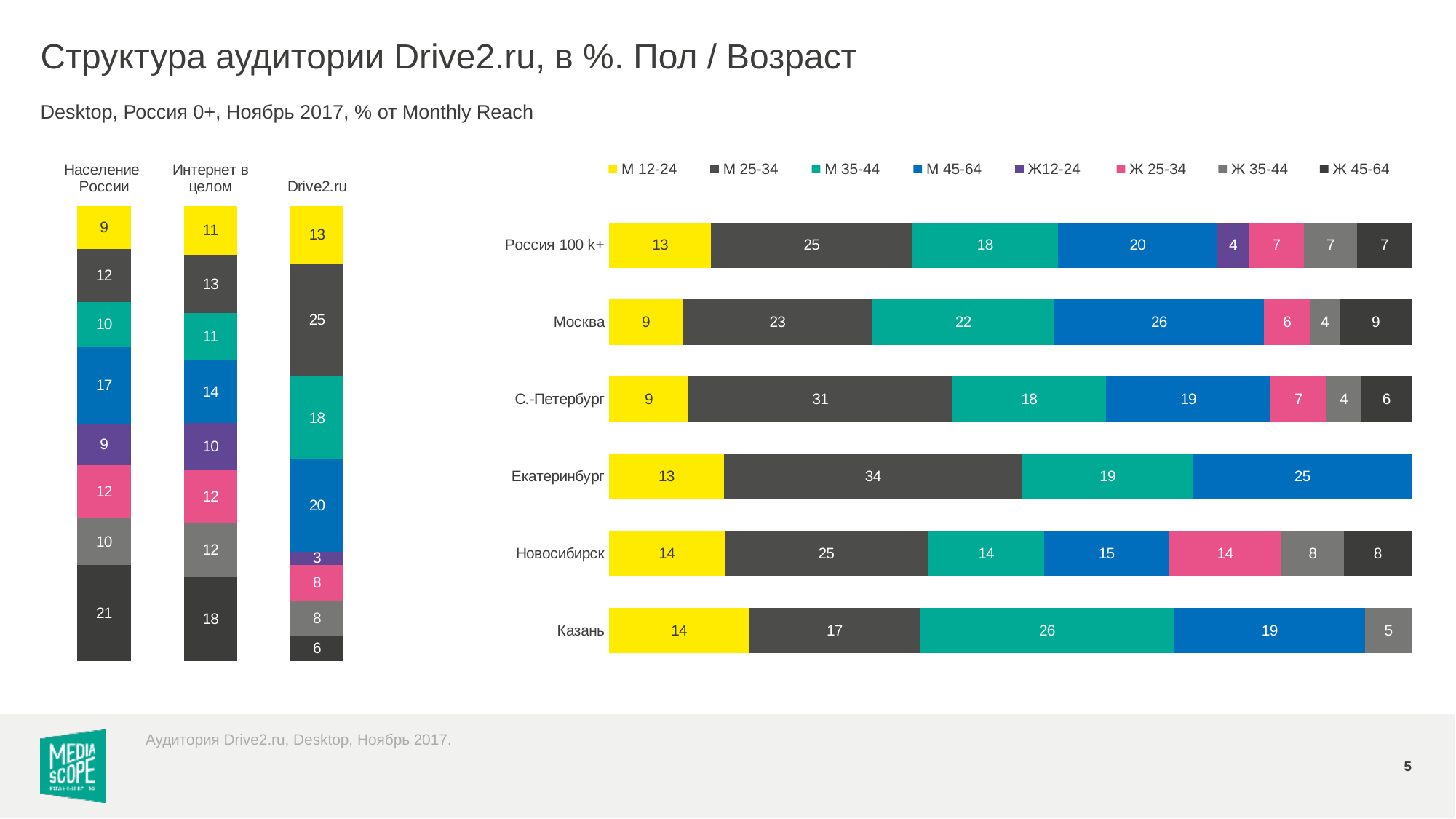
In the right chart, what is the Ж 25-34 value for Новосибирск? 14 In the right chart, which city has the highest М 25-34 value? Екатеринбург What type of chart is the right chart? Stacked bar chart How many cities/regions are shown in the right chart? 6 In the left chart, what is the Ж 45-64 value for Население России? 21 In the right chart, which city has the lowest М 25-34 value? Казань In the left chart, what is the М 25-34 value for Drive2.ru? 25 In the right chart, what is the М 45-64 value for Москва? 26 How many series does the legend of the right chart list? 8 In the right chart, what is the value of the М 25-34 segment for Екатеринбург? 34 In the left chart, what is the difference between the М 25-34 value for Drive2.ru and for Население России? 13 In the right chart, which has the larger М 35-44 value, Казань or Москва? Казань